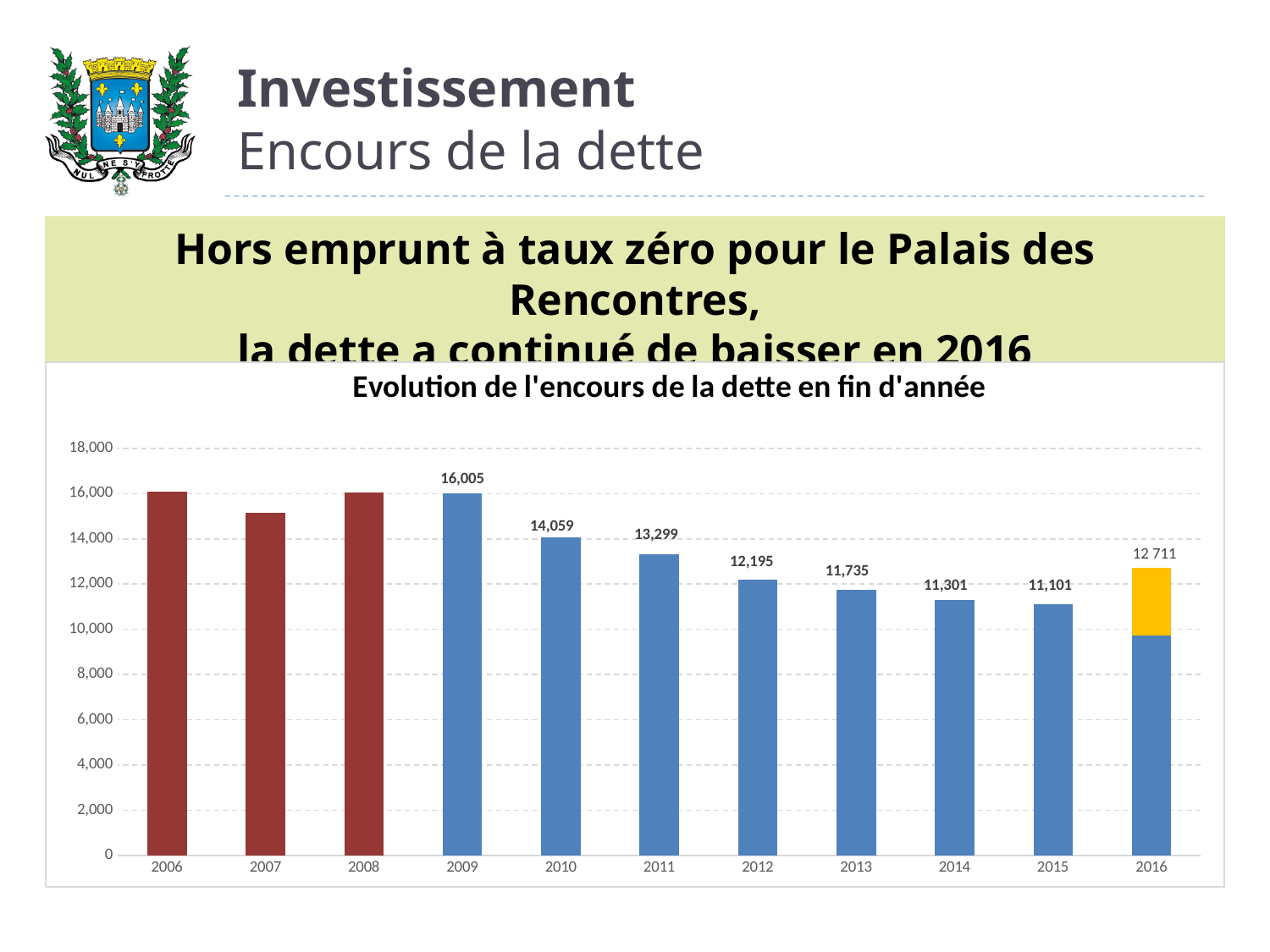
What is the value for 2009 in the chart? 16,005 How many years are shown on the x axis of the chart? 11 Is the value for 2007 greater or less than 16,000? less Do the values rise or fall from 2009 to 2015? fall Which year has the lowest bar in the chart? 2015 What kind of chart is shown on the slide? bar chart What is the value shown above the 2016 bar? 12 711 What is the value for 2012 in the chart? 12,195 What is the difference between the values for 2009 and 2010? 1,946 Which is larger, the value for 2012 or the value for 2013? 2012 What is the difference between the values for 2013 and 2014? 434 What is the value for 2015? 11,101